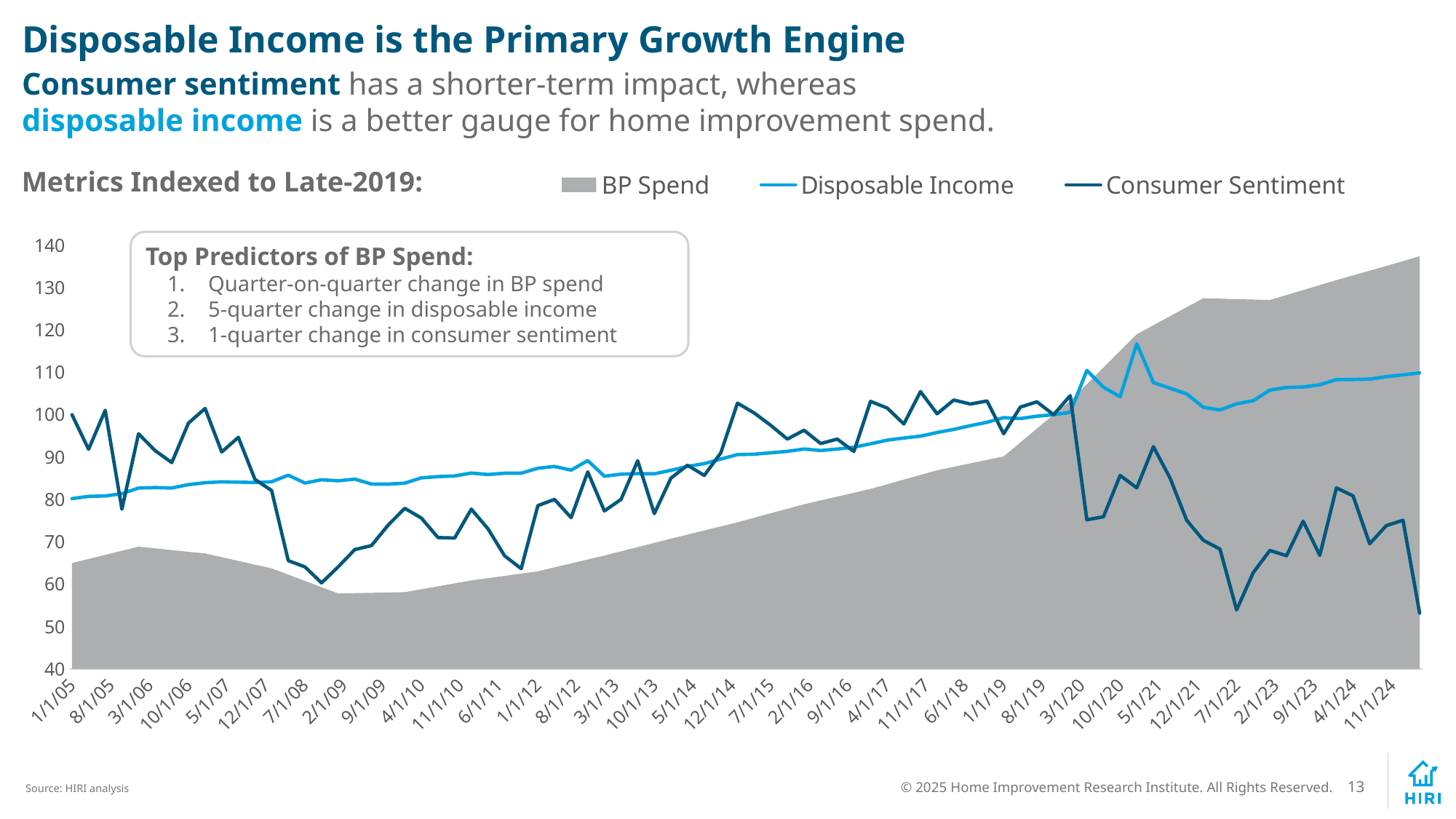
Is the value of Consumer Sentiment at 5/1/21 greater or less than 110? less Is the value of Consumer Sentiment at 7/1/22 greater or less than 60? less Is the value of BP Spend at 11/1/24 greater or less than 130? greater How many series does the chart legend list? 3 Does BP Spend rise or fall between 3/1/06 and 2/1/09? fall At 1/1/05, which is higher: Consumer Sentiment or BP Spend? Consumer Sentiment What is the highest value shown on the chart's y axis? 140 Which series in the chart is drawn as a shaded grey area rather than a line? BP Spend Does the Disposable Income line generally rise or fall from 1/1/05 to 11/1/24? rise At 11/1/24, which is higher: BP Spend or Consumer Sentiment? BP Spend